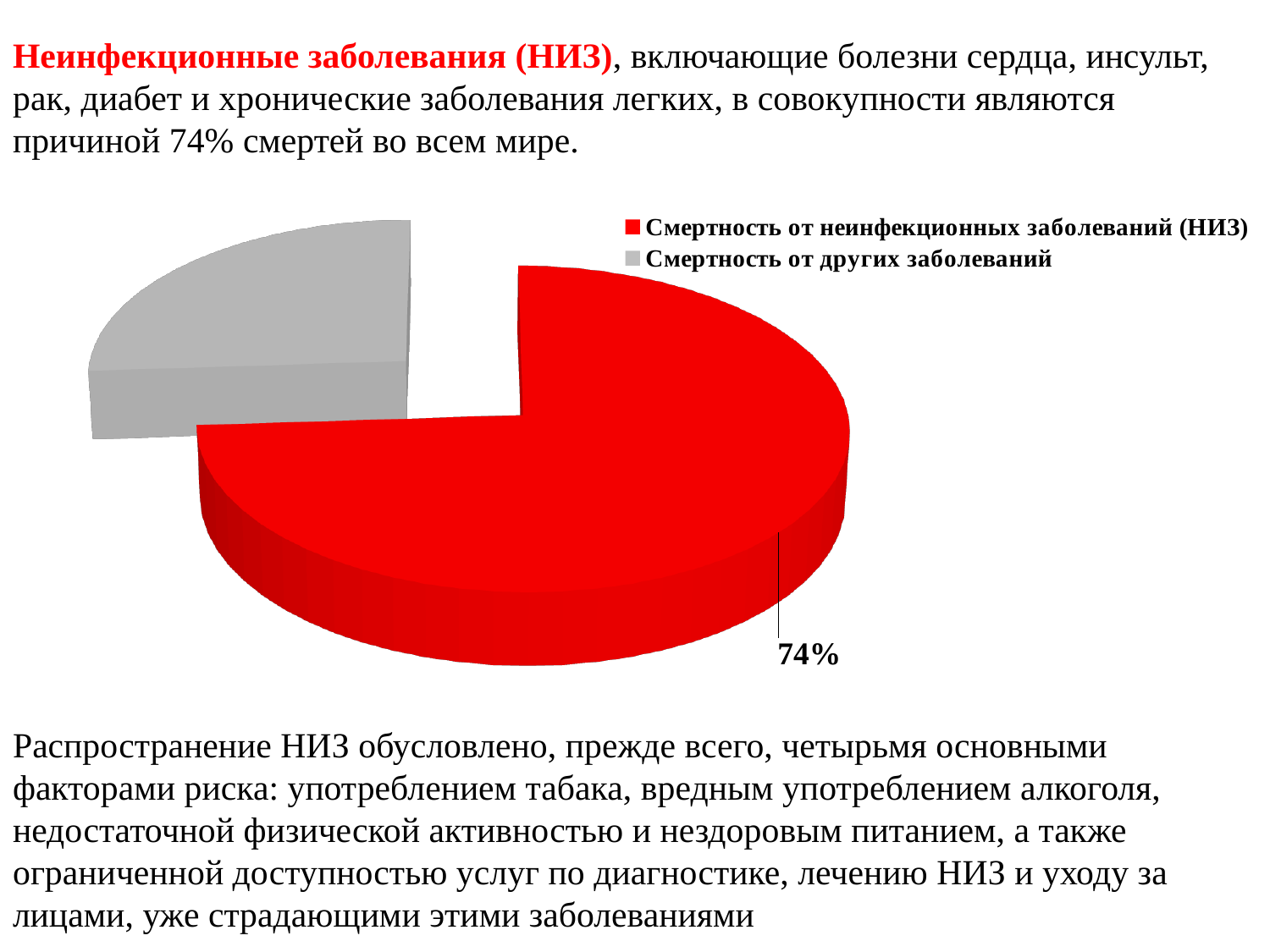
How many slices does the pie chart have? 2 How many entries does the chart legend list? 2 Which slice of the pie chart is the smallest? Смертность от других заболеваний What percentage is shown for the slice 'Смертность от неинфекционных заболеваний (НИЗ)'? 74% What colour is the slice for 'Смертность от других заболеваний'? grey Which slice of the pie chart is the largest? Смертность от неинфекционных заболеваний (НИЗ) What kind of chart is shown on the slide? pie chart What colour is the slice for 'Смертность от неинфекционных заболеваний (НИЗ)'? red Which is larger: 'Смертность от неинфекционных заболеваний (НИЗ)' or 'Смертность от других заболеваний'? Смертность от неинфекционных заболеваний (НИЗ) What share of the pie does 'Смертность от неинфекционных заболеваний (НИЗ)' take? 74%